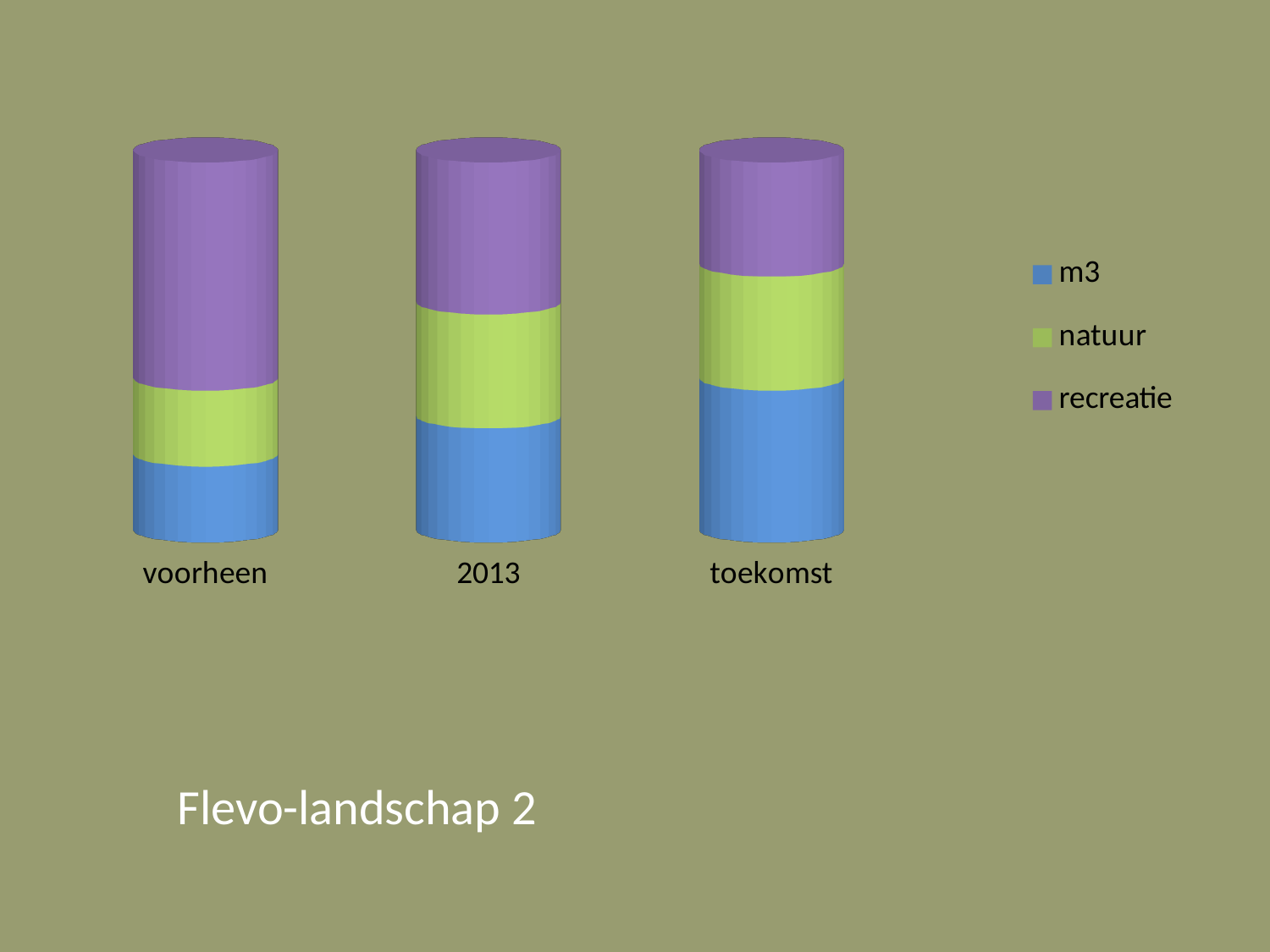
In the voorheen bar, which segment is larger: recreatie or m3? recreatie How many categories are shown along the x axis of the chart? 3 Does the m3 segment rise or fall from voorheen to toekomst? rise Which category has the smallest m3 segment? voorheen How many series does the chart's legend list? 3 Which category has the largest recreatie segment? voorheen Which series are listed in the chart's legend? m3, natuur, recreatie What are the category labels along the x axis of the chart? voorheen, 2013, toekomst What kind of chart is shown on the slide? stacked bar chart Which category has the largest m3 segment? toekomst Does the recreatie segment rise or fall from voorheen to toekomst? fall Which category has the smallest recreatie segment? toekomst